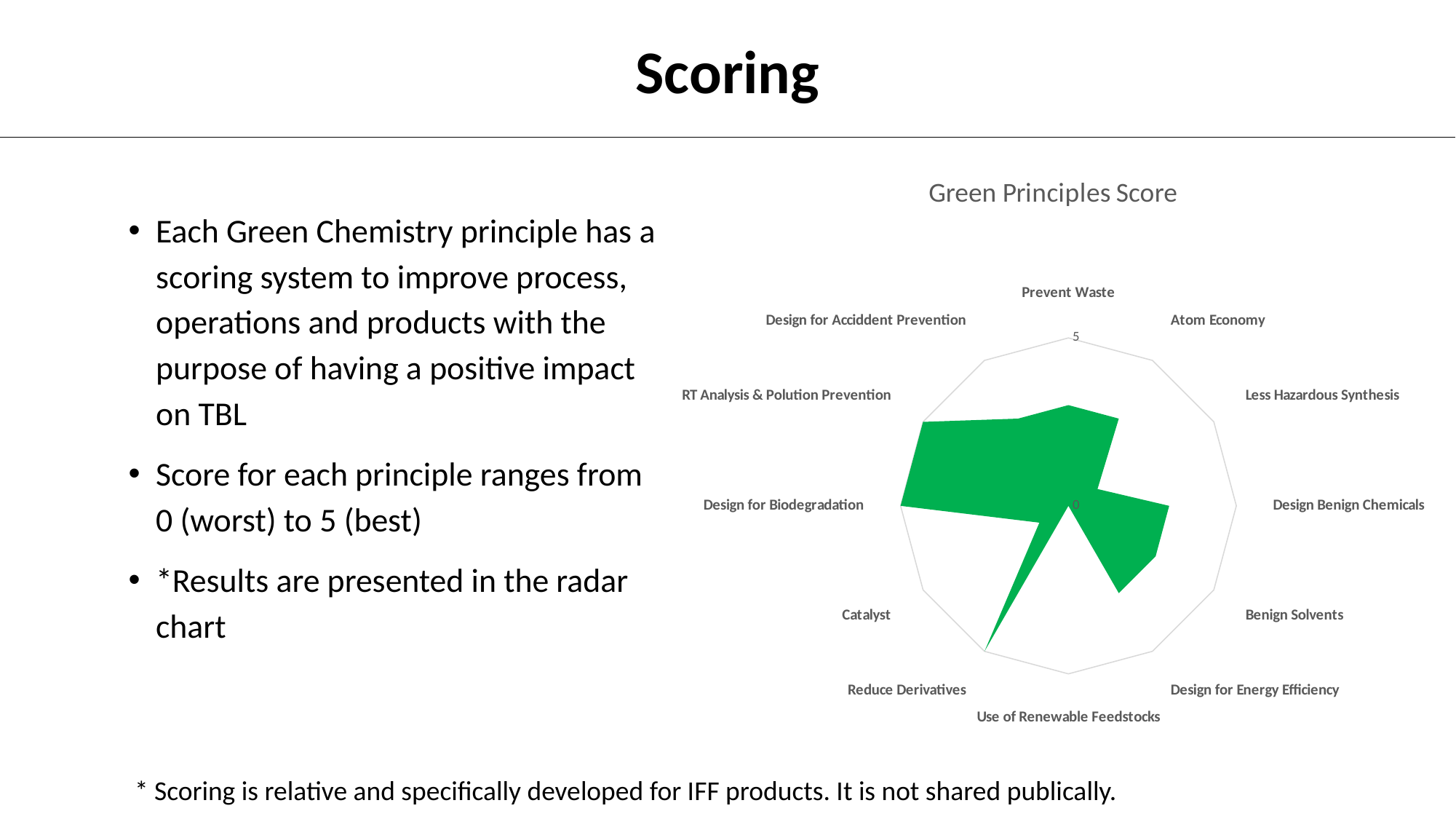
Which has the larger score, Benign Solvents or Catalyst? Benign Solvents Which has the larger score, Design for Biodegradation or Atom Economy? Design for Biodegradation Which has the larger score, RT Analysis & Polution Prevention or Catalyst? RT Analysis & Polution Prevention What is the title of the chart? Green Principles Score What is the maximum value shown on the radar chart's axis? 5 What kind of chart is shown on the slide? Radar chart How many principles (categories) are plotted on the radar chart? 12